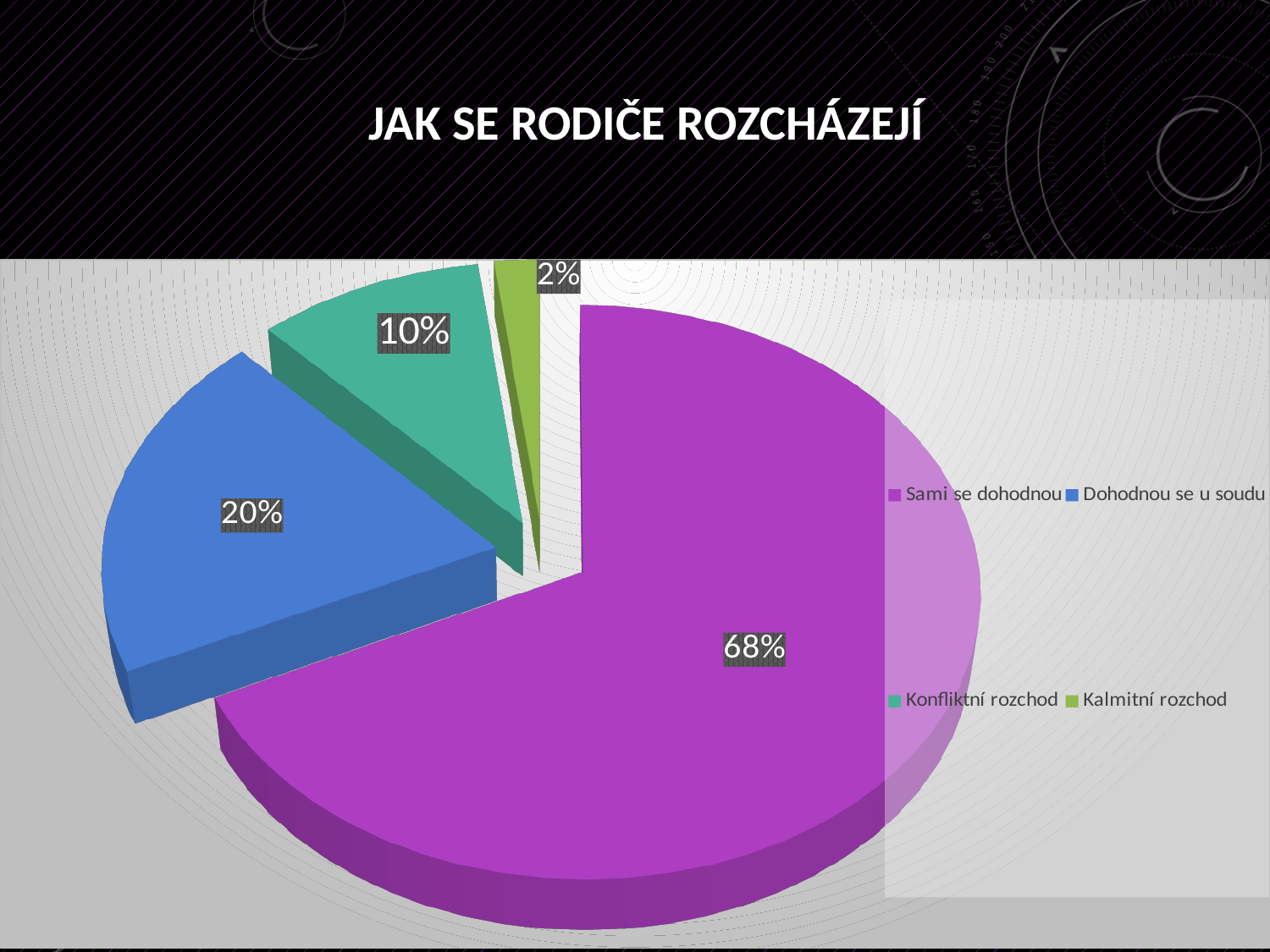
How many categories does the legend list? 4 What kind of chart is shown on the slide? pie chart Which category has the largest share of the pie? Sami se dohodnou What percentage is shown for "Kalmitní rozchod"? 2% What is the difference in percentage points between "Sami se dohodnou" and "Dohodnou se u soudu"? 48 What is the title of the slide? JAK SE RODIČE ROZCHÁZEJÍ Which is larger, the share for "Konfliktní rozchod" or the share for "Kalmitní rozchod"? Konfliktní rozchod What percentage is shown for "Konfliktní rozchod"? 10% What colour is the slice for "Dohodnou se u soudu"? blue What percentage is shown for "Dohodnou se u soudu"? 20% Which category has the smallest share of the pie? Kalmitní rozchod What percentage is shown for "Sami se dohodnou"? 68%